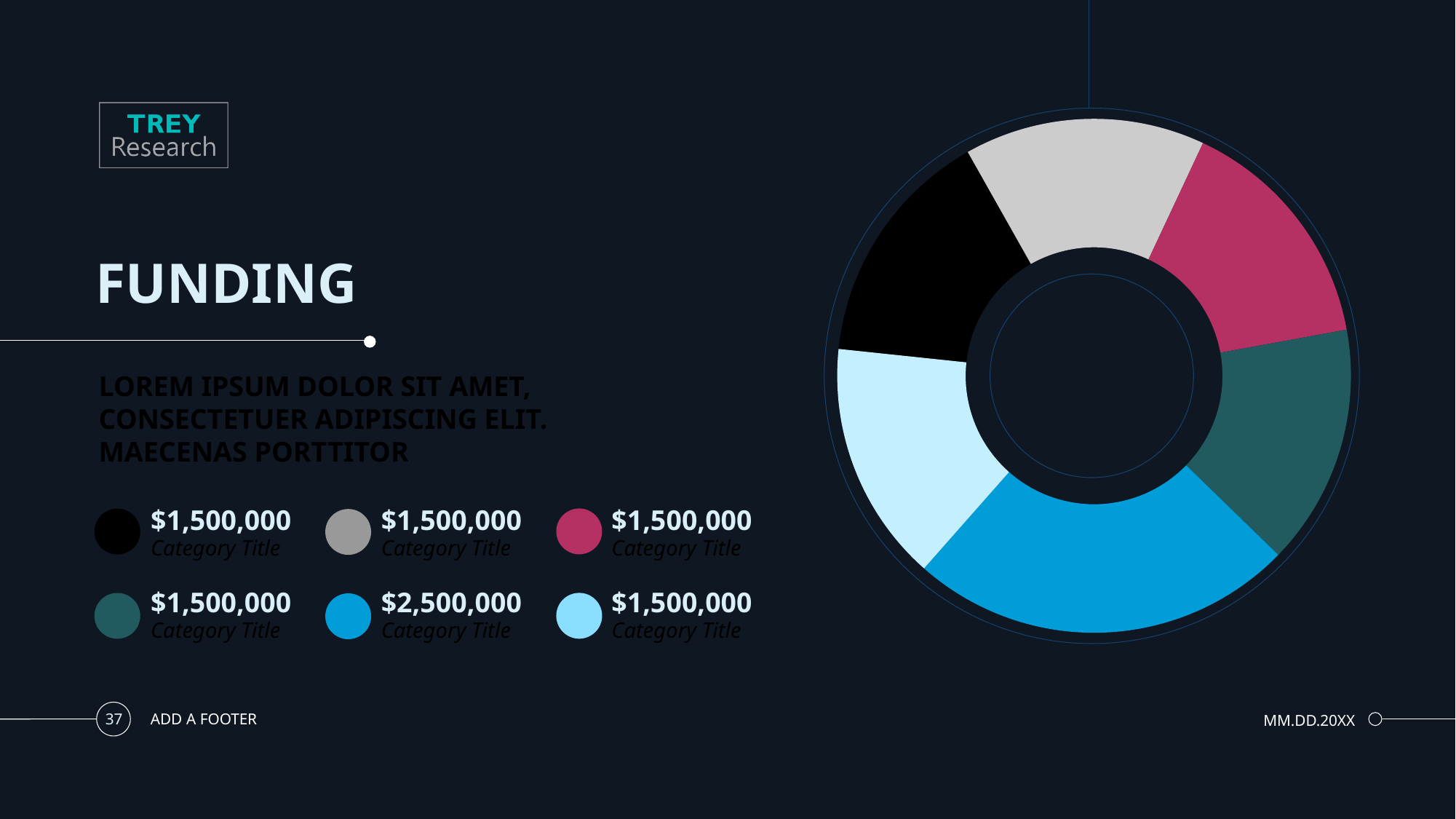
What is the value of the blue slice in the donut chart? $2,500,000 What is the difference between the blue slice and the light blue slice? $1,000,000 Which is larger, the blue slice or the gray slice? The blue slice What is the title of the slide containing the donut chart? FUNDING Which slice of the donut chart is the largest? The blue slice ($2,500,000) What is the total of all six slices in the donut chart? $10,000,000 What is the value of the black slice in the donut chart? $1,500,000 What kind of chart is shown on the slide? Pie chart (donut) How many slices does the donut chart have? 6 What share of the total does the blue slice represent? 25% What share of the total does the dark teal slice represent? 15% What is the value of the magenta slice in the donut chart? $1,500,000